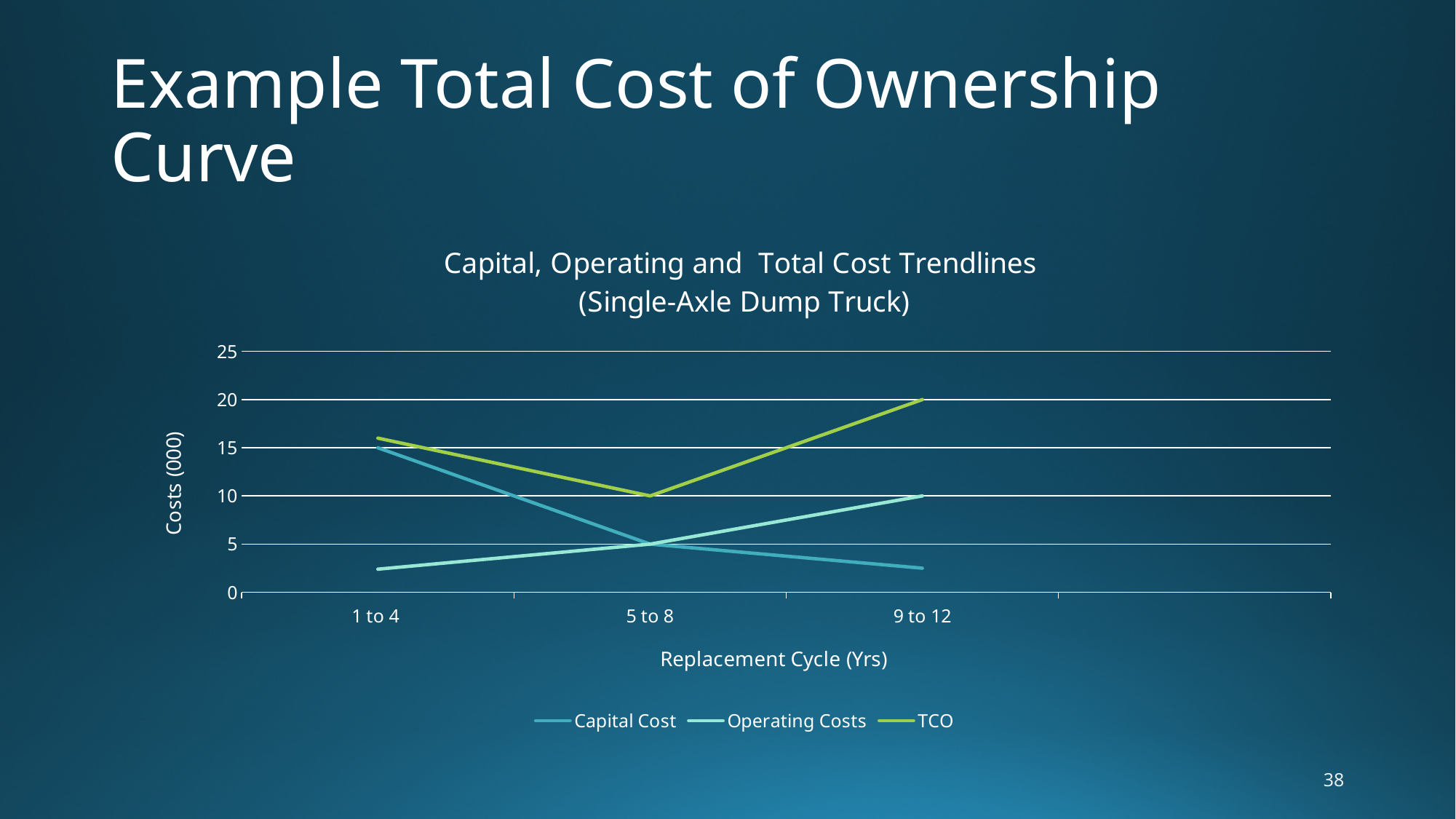
Does the TCO line rise or fall between the 5 to 8 and 9 to 12 replacement cycles? rise What is the difference between the TCO for 9 to 12 and the TCO for 5 to 8? 10 What is the title of the chart? Capital, Operating and Total Cost Trendlines (Single-Axle Dump Truck) How many series does the legend list? 3 What is the TCO value for the 9 to 12 replacement cycle? 20 Which series has the highest value at the 9 to 12 replacement cycle? TCO What is the TCO value for the 5 to 8 replacement cycle? 10 Which replacement cycle has the lowest TCO? 5 to 8 Which replacement cycle has the highest TCO? 9 to 12 What kind of chart is shown on the slide? line chart How many replacement cycle categories are shown on the x axis? 3 Is the TCO value for the 1 to 4 replacement cycle greater or less than 15? greater